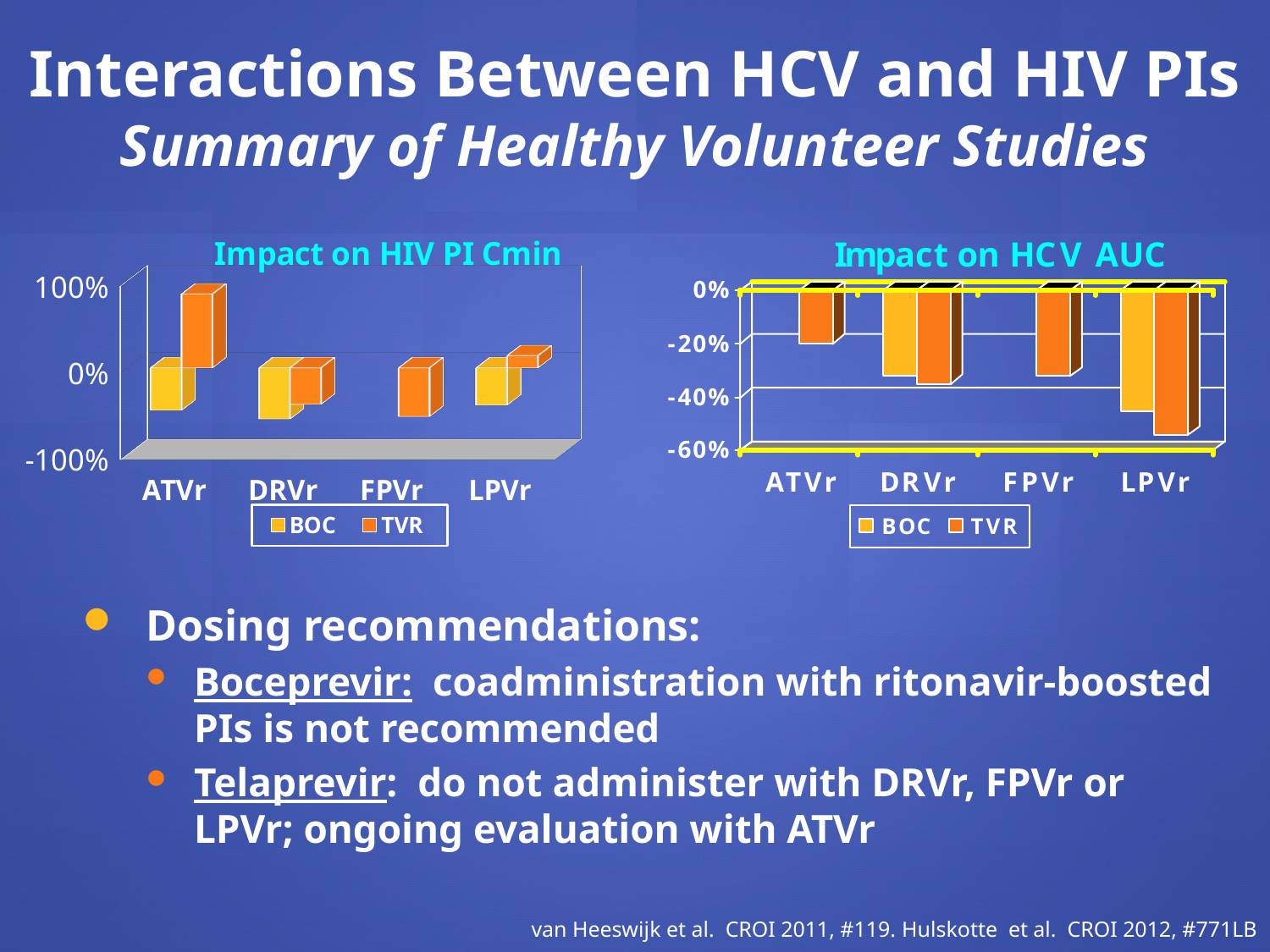
What kind of chart is the "Impact on HIV PI Cmin" chart? Bar chart In the "Impact on HIV PI Cmin" chart, which category has the highest TVR value? ATVr In the "Impact on HCV AUC" chart, which category has the lowest TVR value? LPVr In the "Impact on HCV AUC" chart, is the TVR value for DRVr greater or less than -20%? less In the "Impact on HCV AUC" chart, is the TVR value for LPVr greater or less than -40%? less What are the two legend entries in the "Impact on HCV AUC" chart? BOC and TVR In the "Impact on HIV PI Cmin" chart, is the BOC value for DRVr greater or less than 0%? less How many categories are shown on the x axis of the "Impact on HIV PI Cmin" chart? 4 In the "Impact on HIV PI Cmin" chart, which is larger, the TVR value for ATVr or the TVR value for LPVr? ATVr In the "Impact on HCV AUC" chart, which is larger, the BOC value for DRVr or the BOC value for LPVr? DRVr How many series does the legend of the "Impact on HCV AUC" chart list? 2